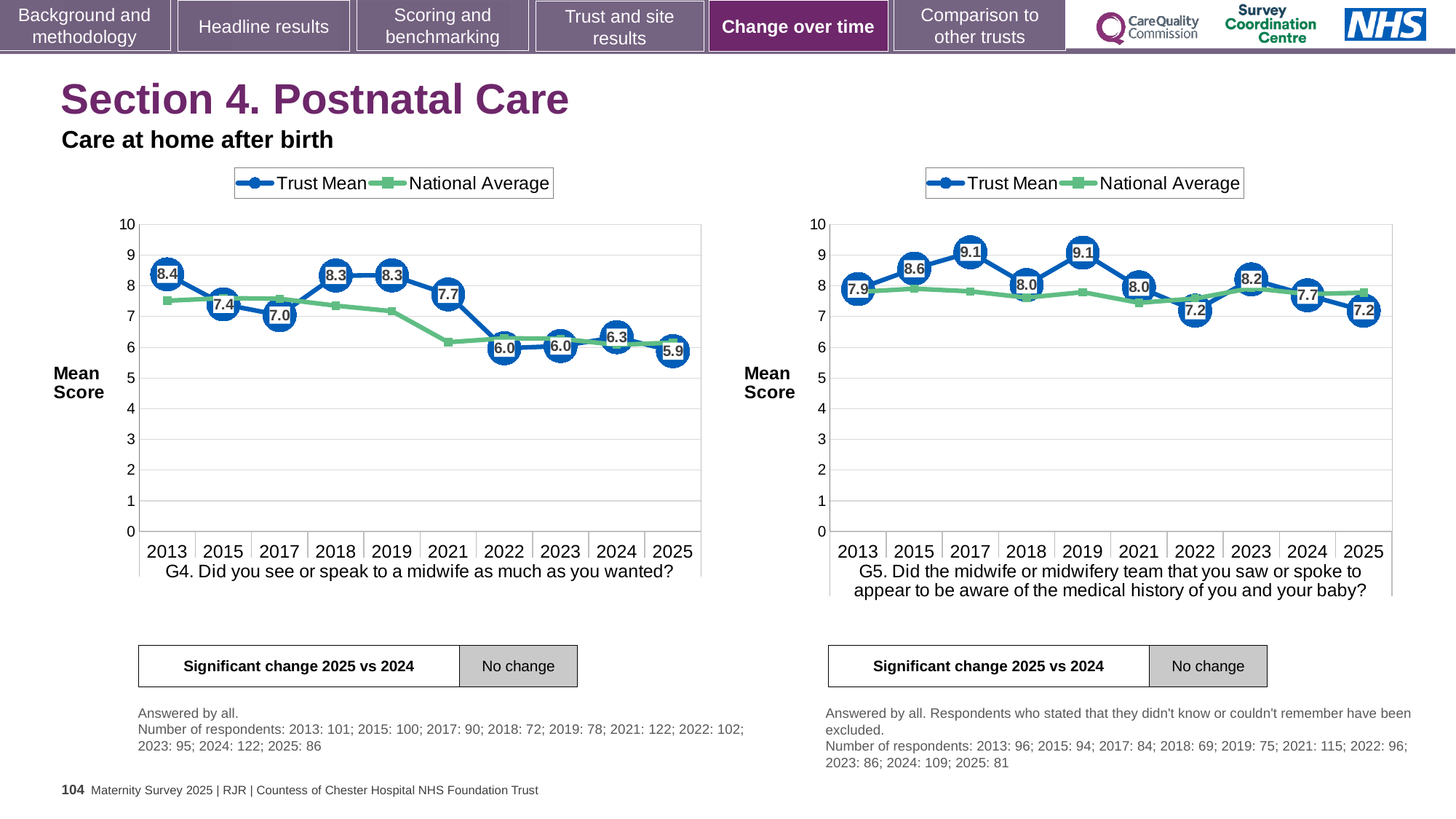
In the G5 chart (right), what is the difference between the Trust Mean in 2019 and in 2022? 1.9 In the G4 chart (left), does the Trust Mean overall rise or fall from 2013 to 2025? fall How many years are plotted on the x axis of the G5 chart (right)? 10 In the G4 chart (left), what is the Trust Mean for 2025? 5.9 How many series does the legend of the G4 chart (left) list? 2 In the G4 chart (left), is the National Average for 2013 greater or less than 7? greater In the G5 chart (right), what is the Trust Mean for 2024? 7.7 In the G5 chart (right), what is the Trust Mean for 2017? 9.1 In the G5 chart (right), which is larger, the Trust Mean for 2015 or for 2018? 2015 In the G4 chart (left), what is the difference between the Trust Mean in 2013 and in 2025? 2.5 In the G4 chart (left), which year has the lowest Trust Mean? 2025 In the G4 chart (left), what is the Trust Mean for 2013? 8.4